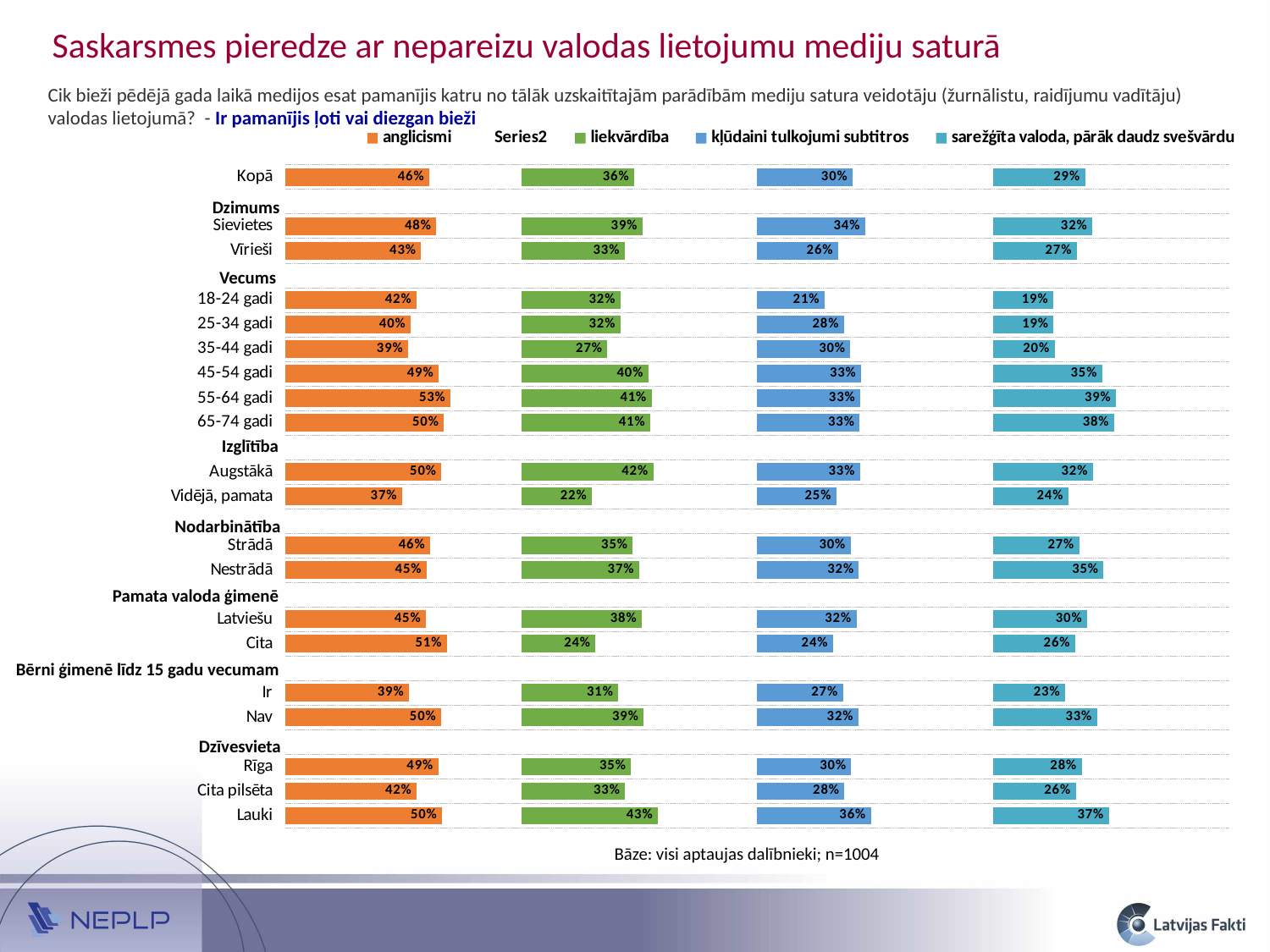
What is the difference between Augstākā and Vidējā, pamata in the anglicismi series? 13 percentage points What is the value for Lauki in the liekvārdība series? 43% What is the value for Vīrieši in the kļūdaini tulkojumi subtitros series? 26% What is the base (sample size) stated below the chart? n=1004 Which category has the highest value in the anglicismi series? 55-64 gadi What type of chart is shown on the slide? Bar chart What is the value for 55-64 gadi in the sarežģīta valoda, pārāk daudz svešvārdu series? 39% Which category has the lowest value in the anglicismi series? Vidējā, pamata What is the difference between Sievietes and Vīrieši in the liekvārdība series? 6 percentage points What is the value for Kopā in the anglicismi series? 46% In the anglicismi series, which is larger: Cita or Latviešu? Cita Which category has the lowest value in the kļūdaini tulkojumi subtitros series? 18-24 gadi